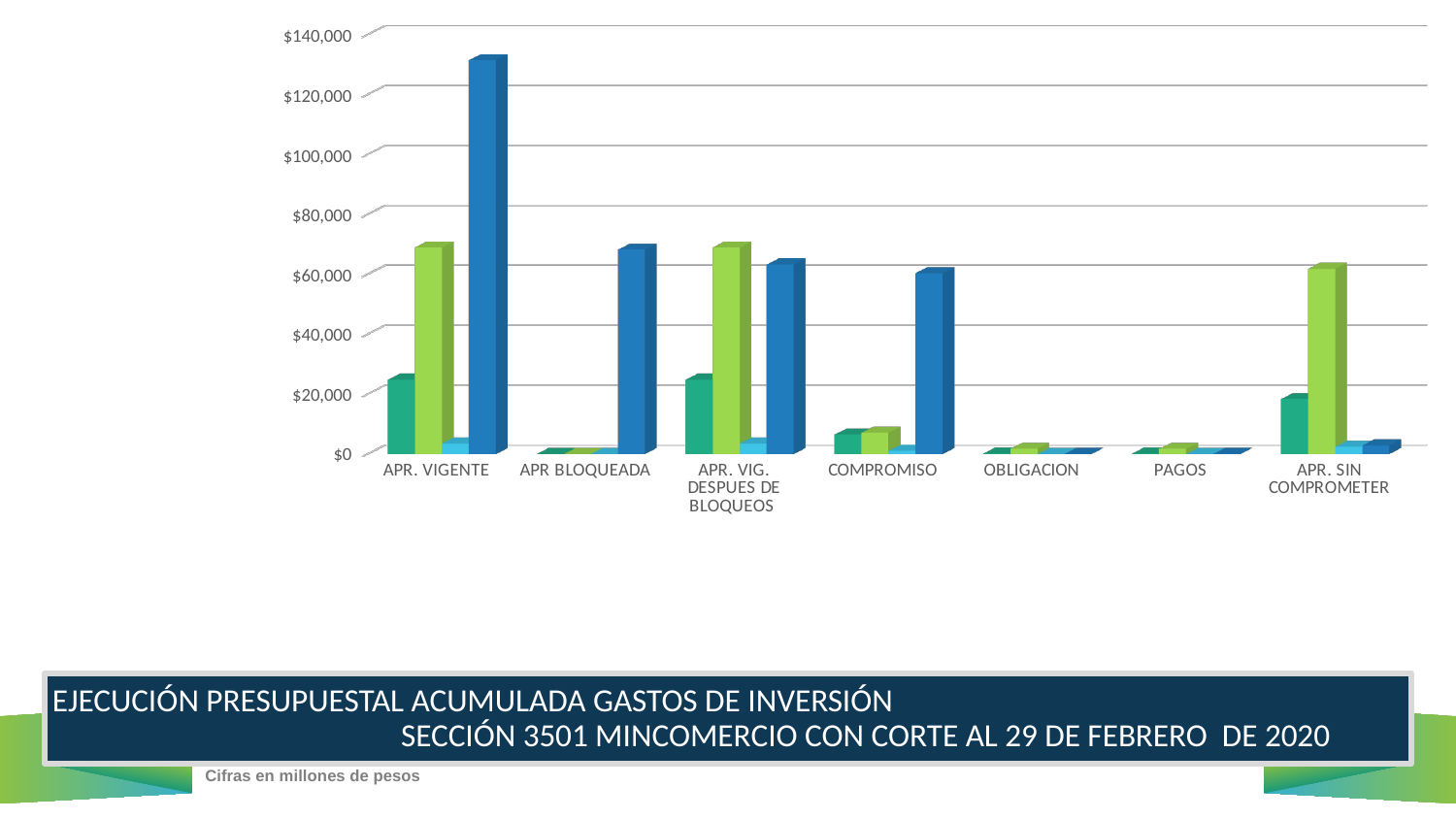
Is the value of the green bar for APR. VIGENTE greater or less than $60,000? greater For APR. SIN COMPROMETER, which bar is taller, the green bar or the dark blue bar? the green bar How many categories are shown along the x axis of the chart? 7 How many bars are plotted for each category in the chart? 4 Is the value of the teal bar for APR. SIN COMPROMETER greater or less than $40,000? less Is the value of the dark blue bar for APR. VIGENTE greater or less than $120,000? greater What kind of chart is shown on the slide? bar chart Which has the larger dark blue bar, APR. VIGENTE or APR BLOQUEADA? APR. VIGENTE According to the note below the chart, in what units are the figures expressed? Cifras en millones de pesos Which category contains the tallest bar in the chart? APR. VIGENTE